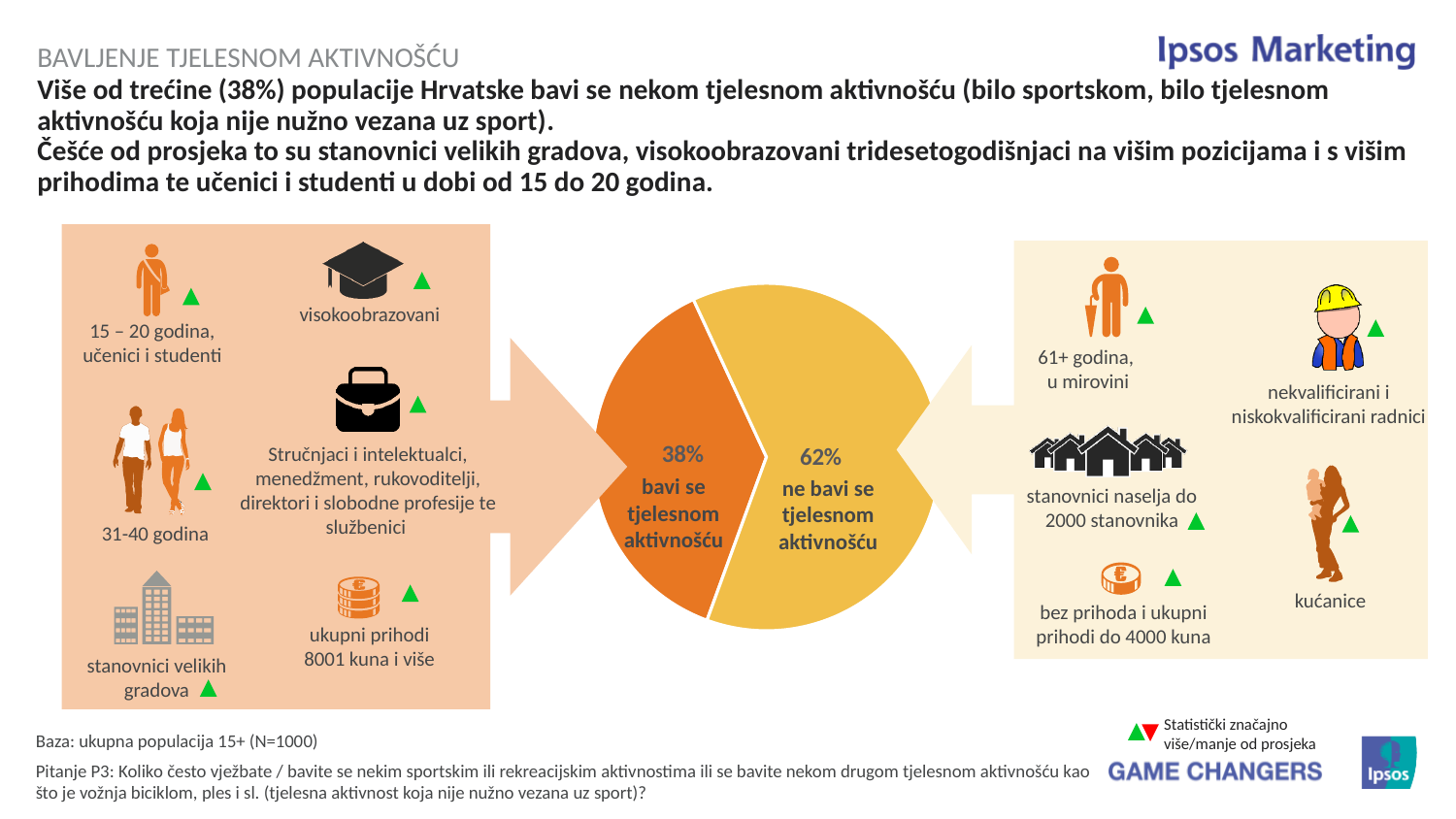
What share of the pie does the "bavi se tjelesnom aktivnošću" slice represent? 38% What kind of chart is shown in the centre of the slide? pie chart How many slices does the pie chart have? 2 What is the difference in percentage points between the "ne bavi se tjelesnom aktivnošću" slice and the "bavi se tjelesnom aktivnošću" slice? 24 percentage points Which slice of the pie chart is the smallest? bavi se tjelesnom aktivnošću What is the base (sample size) stated for the pie chart? ukupna populacija 15+ (N=1000) What colour is the "bavi se tjelesnom aktivnošću" slice of the pie chart? orange Which slice of the pie chart is the largest? ne bavi se tjelesnom aktivnošću What percentage of the pie chart is labelled "bavi se tjelesnom aktivnošću"? 38% What percentage of the pie chart is labelled "ne bavi se tjelesnom aktivnošću"? 62% Which is larger in the pie chart: "bavi se tjelesnom aktivnošću" or "ne bavi se tjelesnom aktivnošću"? ne bavi se tjelesnom aktivnošću What is the total of the two slices in the pie chart? 100%